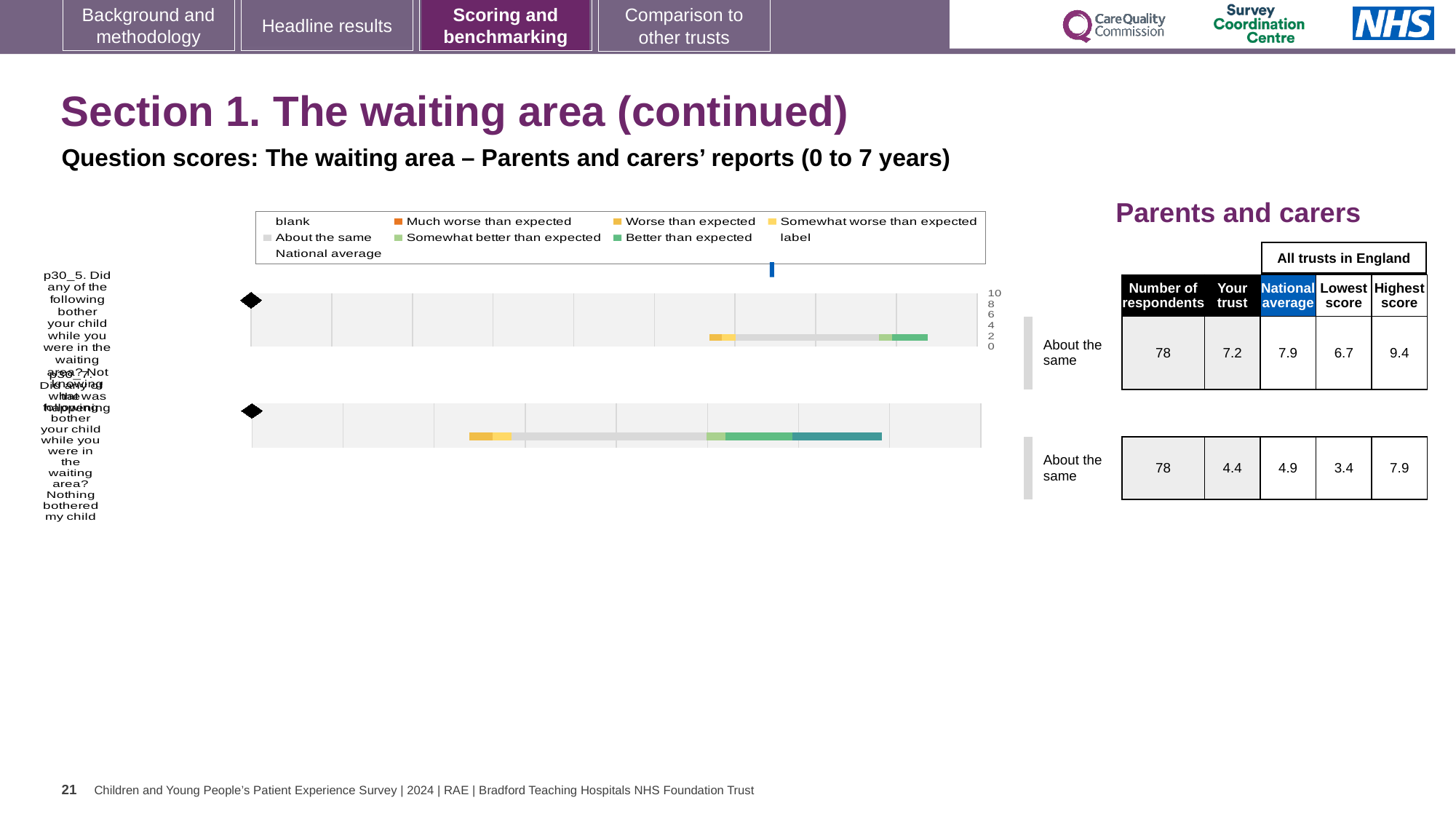
How many survey questions are plotted in the chart? 2 What kind of chart is used to show the question scores? Bar chart For question p30_5, which is larger: the 'Your trust' score or the national average? National average Which question has the higher 'Your trust' score, p30_5 or p30_7? p30_5 What is the highest score across all trusts in England for question p30_7? 7.9 What is the difference between the highest score and the lowest score for question p30_5? 2.7 By how much does the national average exceed the 'Your trust' score for question p30_7? 0.5 What is the 'Your trust' score for question p30_5 (Not knowing what was happening)? 7.2 How many respondents are shown for question p30_5? 78 What benchmark category is given for question p30_7? About the same What heading appears above the score table on the right of the slide? Parents and carers What is the national average score for question p30_7 (Nothing bothered my child)? 4.9